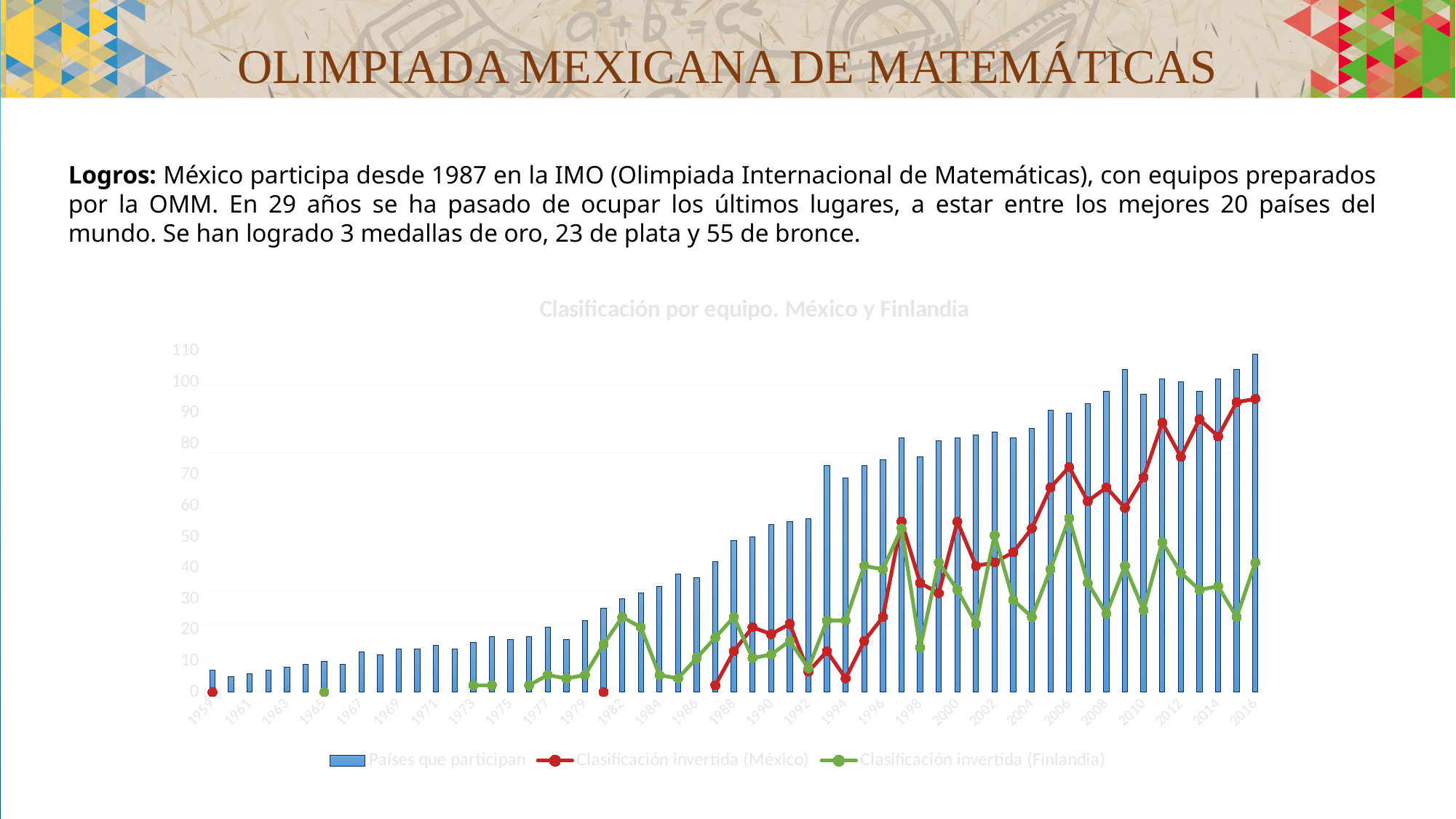
In which year is the value of Países que participan highest? 2016 In 2016, which is larger: Clasificación invertida (México) or Clasificación invertida (Finlandia)? Clasificación invertida (México) How many series does the legend of the chart list? 3 What kind of chart is shown on the slide? A combined bar and line chart Is the value of Países que participan in 2016 greater or less than 100? greater Is the value of Países que participan in 1959 greater or less than 10? less What is the title of the chart? Clasificación por equipo. México y Finlandia Do the values of Países que participan generally rise or fall from 1959 to 2016? rise Is the value of Clasificación invertida (Finlandia) in 2006 greater or less than 50? greater Which series is drawn as bars in the chart? Países que participan